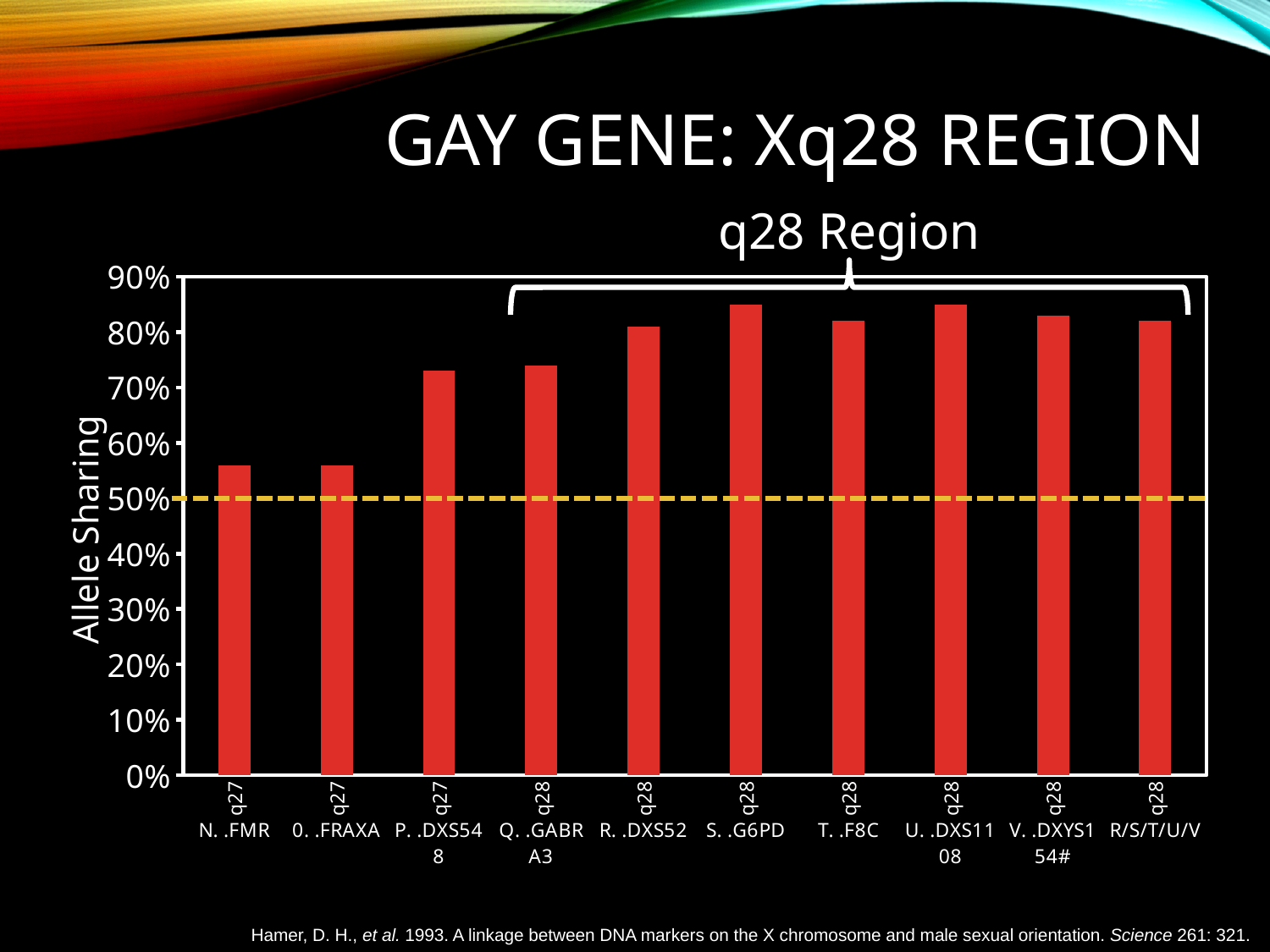
Is the value for Q..GABRA3 greater or less than 80%? less At what value does the dashed horizontal line cross the chart? 50% Do the values generally rise or fall moving from left to right along the x axis? rise Which has the larger value, P..DXS548 or N..FMR? P..DXS548 Is the value for P..DXS548 greater or less than 70%? greater How many bars (markers) are plotted in the chart? 10 What kind of chart is shown on the slide? bar chart Is the value for S..G6PD greater or less than 80%? greater What is the label on the vertical axis of the chart? Allele Sharing